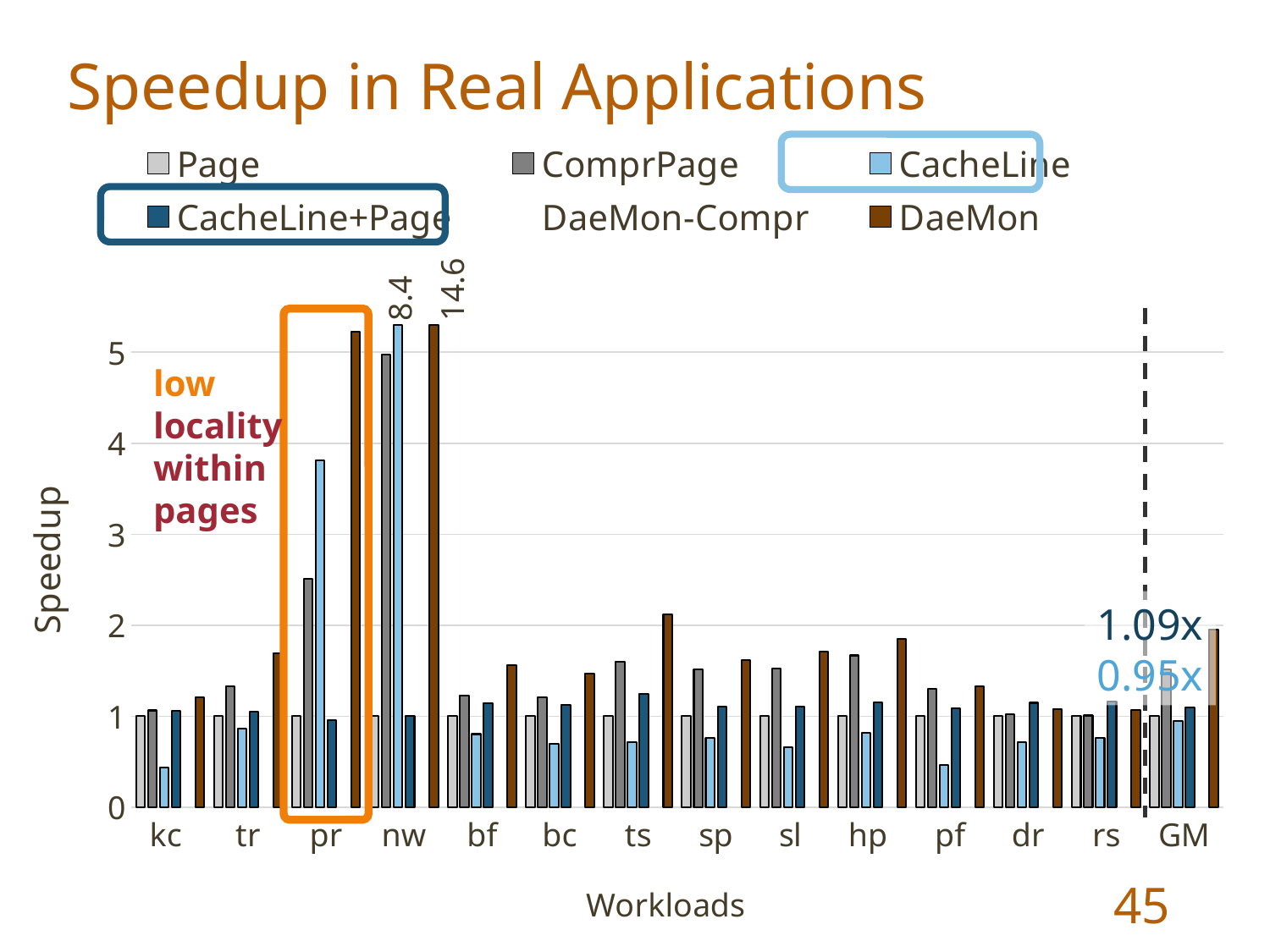
What is the difference between the DaeMon and CacheLine speedups for the nw workload? 6.2 For the nw workload, which is larger: the DaeMon speedup or the CacheLine speedup? DaeMon Is the DaeMon speedup for the pr workload greater or less than 5? greater What is the title of the chart on the slide? Speedup in Real Applications What is the DaeMon speedup for the nw workload? 14.6 For the pr workload, which is larger: the CacheLine speedup or the ComprPage speedup? CacheLine Is the CacheLine speedup for the kc workload greater or less than 1? less What type of chart is shown on the slide? bar chart What is the CacheLine speedup for the nw workload? 8.4 Which workload has the highest DaeMon speedup? nw How many series does the legend list? 6 How many workload categories are shown on the x axis? 14